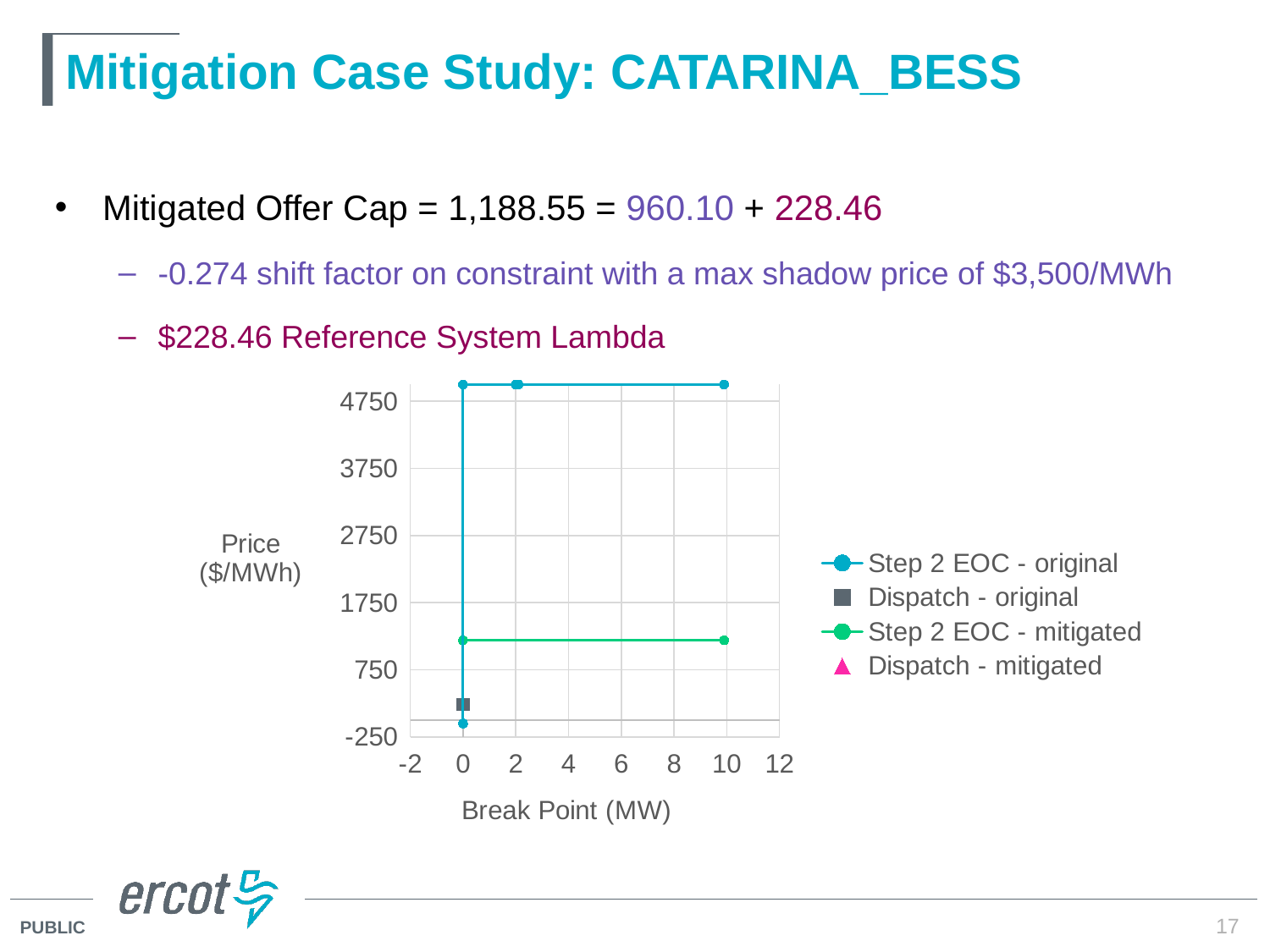
Is the price of the Step 2 EOC - original series at 2 MW greater or less than 3750? greater Is the price of the Step 2 EOC - mitigated series at 10 MW greater or less than 750? greater What kind of chart is shown on the slide? line chart What is the label of the vertical axis of the chart? Price ($/MWh) What is the label of the horizontal axis of the chart? Break Point (MW) At what break point (MW) is the Dispatch - original marker plotted? 0 Does the Step 2 EOC - mitigated price rise, fall, or stay flat between 0 MW and 10 MW? stays flat At 10 MW, which series has the higher price: Step 2 EOC - original or Step 2 EOC - mitigated? Step 2 EOC - original Is the price of the Step 2 EOC - mitigated series at 10 MW greater or less than 1750? less How many series does the chart legend list? 4